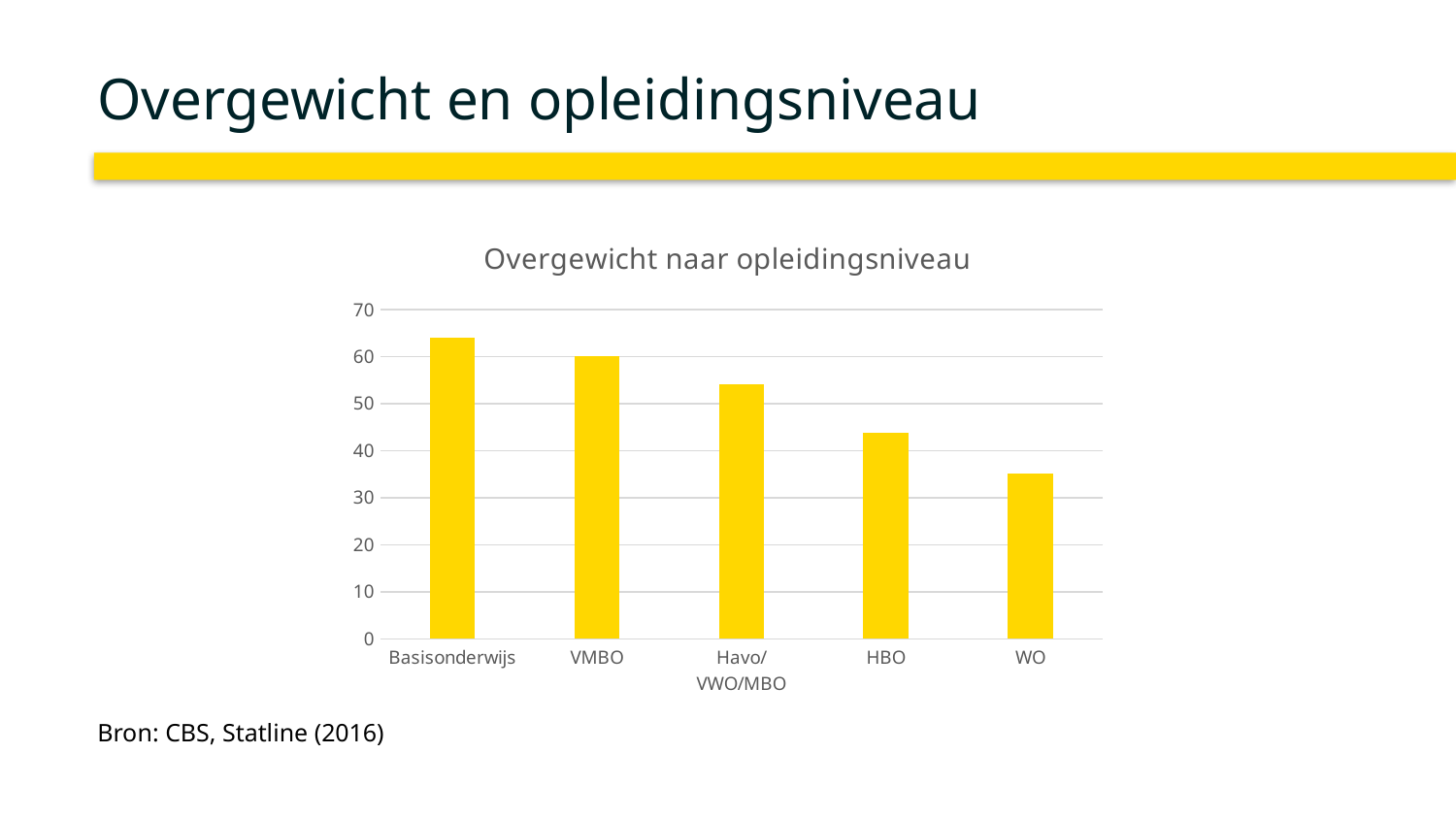
Is the value for Havo/VWO/MBO greater or less than 50? greater What kind of chart is shown on the slide? bar chart What source is cited below the chart? CBS, Statline (2016) Is the value for WO greater or less than 40? less How many categories are shown on the x axis of the chart? 5 Do the values rise or fall from left to right along the x axis? fall What is the title of the chart? Overgewicht naar opleidingsniveau Is the value for HBO greater or less than 40? greater Which category has the lowest value in the chart? WO Which is larger, the value for VMBO or the value for HBO? VMBO Which category has the highest value in the chart? Basisonderwijs